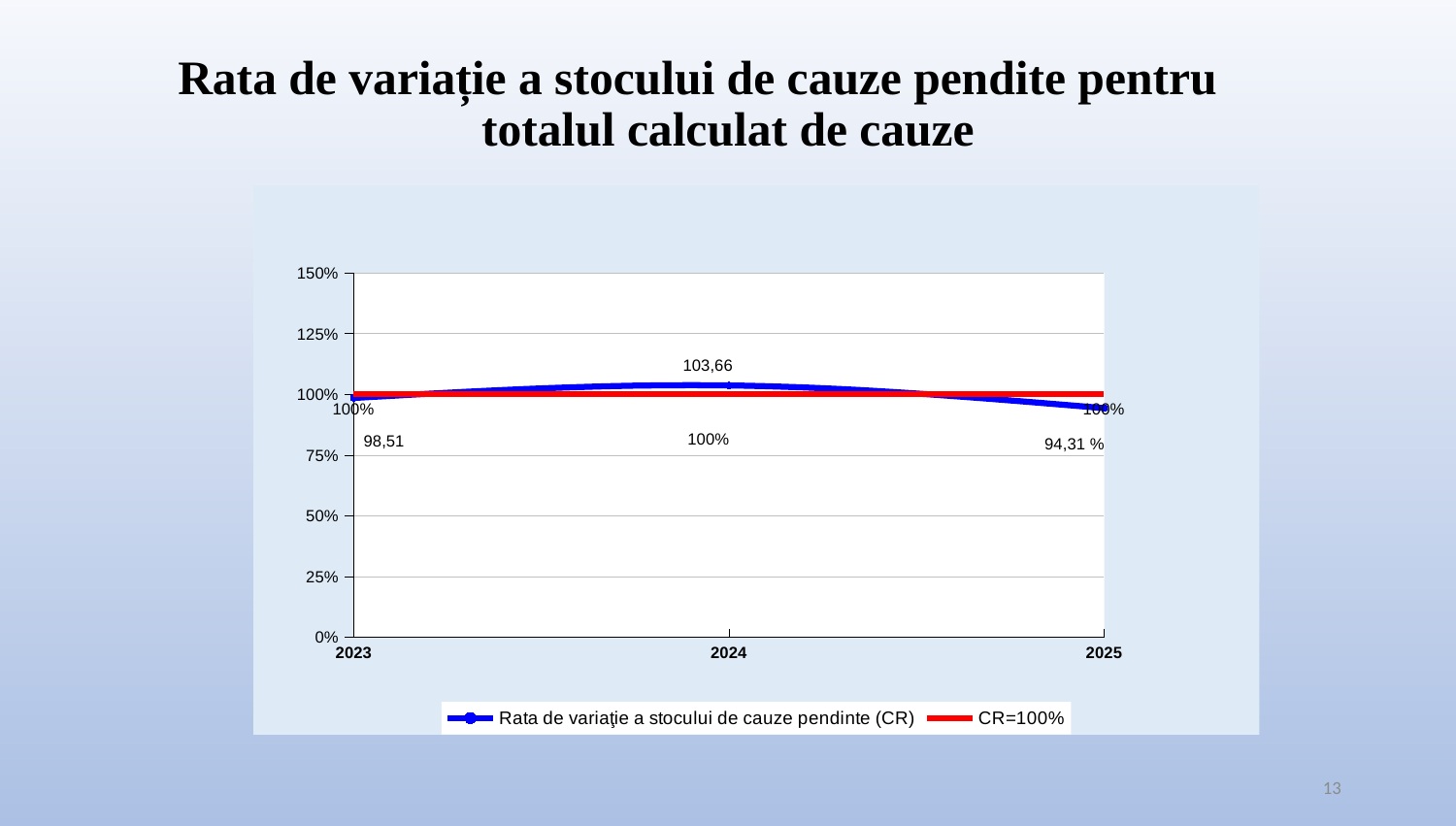
In which year is the 'Rata de variație a stocului de cauze pendinte (CR)' series highest? 2024 Which year has the larger CR value, 2023 or 2025? 2023 How many series does the legend list? 2 What is the value of the 'Rata de variație a stocului de cauze pendinte (CR)' series for 2023? 98,51 How many years are plotted on the x axis? 3 What is the value of the 'Rata de variație a stocului de cauze pendinte (CR)' series for 2025? 94,31 % What value does the 'CR=100%' series hold in every year? 100% In which year is the 'Rata de variație a stocului de cauze pendinte (CR)' series lowest? 2025 Is the CR value for 2024 greater or less than 100%? greater What is the value of the 'Rata de variație a stocului de cauze pendinte (CR)' series for 2024? 103,66 What is the difference between the CR values for 2024 and 2023? 5,15 What kind of chart is shown on the slide? line chart